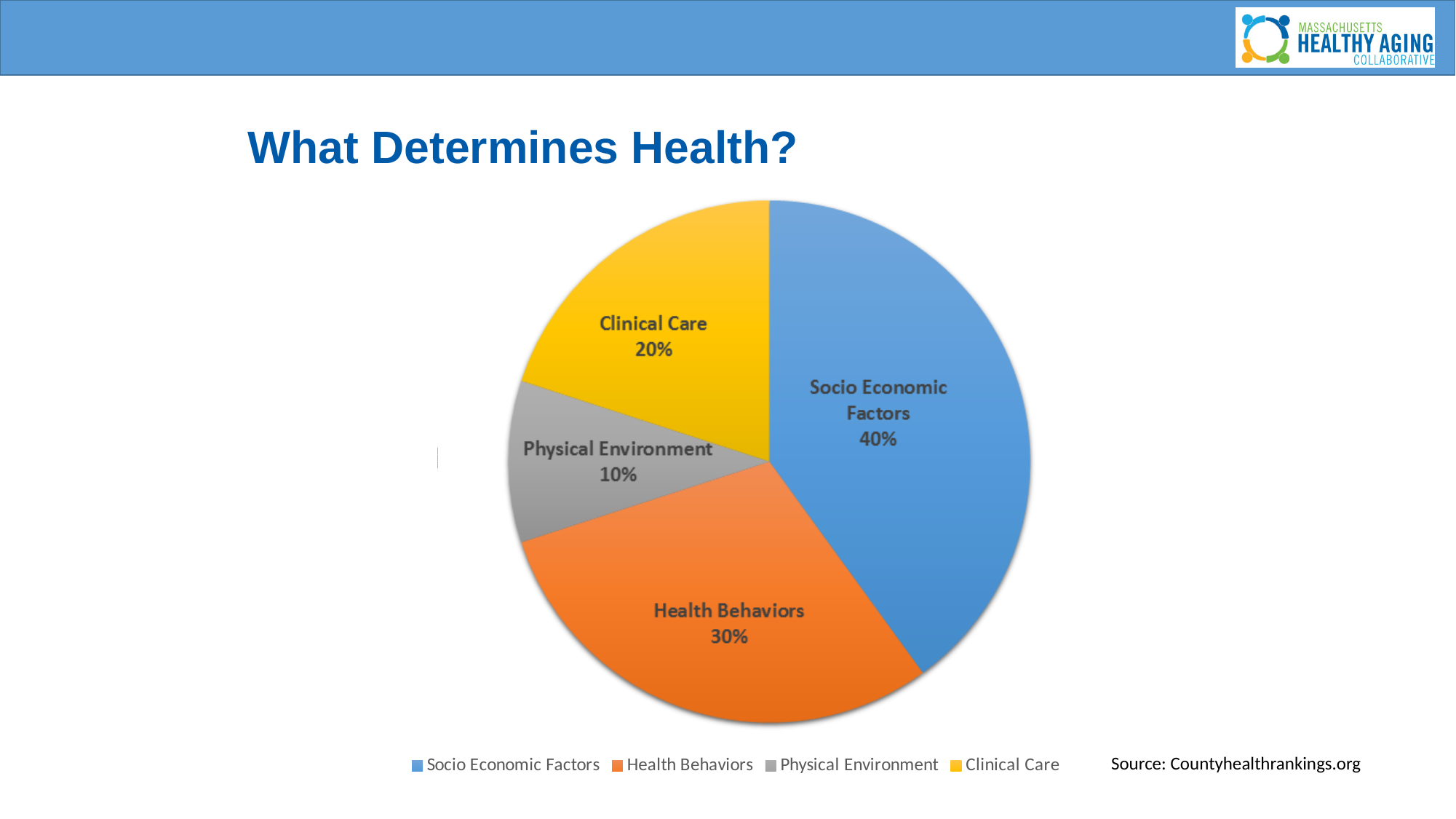
What is the value shown for Clinical Care? 20% What share of the pie does Socio Economic Factors represent? 40% What kind of chart is shown on the slide? pie chart Which is larger, Health Behaviors or Clinical Care? Health Behaviors Which category has the smallest slice of the pie? Physical Environment What is the value shown for Health Behaviors? 30% How many categories are shown in the pie chart? 4 What is the value shown for Physical Environment? 10% What is the title of the slide containing the pie chart? What Determines Health? What colour is the Health Behaviors slice? orange What is the difference between the Socio Economic Factors and Clinical Care percentages? 20% Which category has the largest slice of the pie? Socio Economic Factors